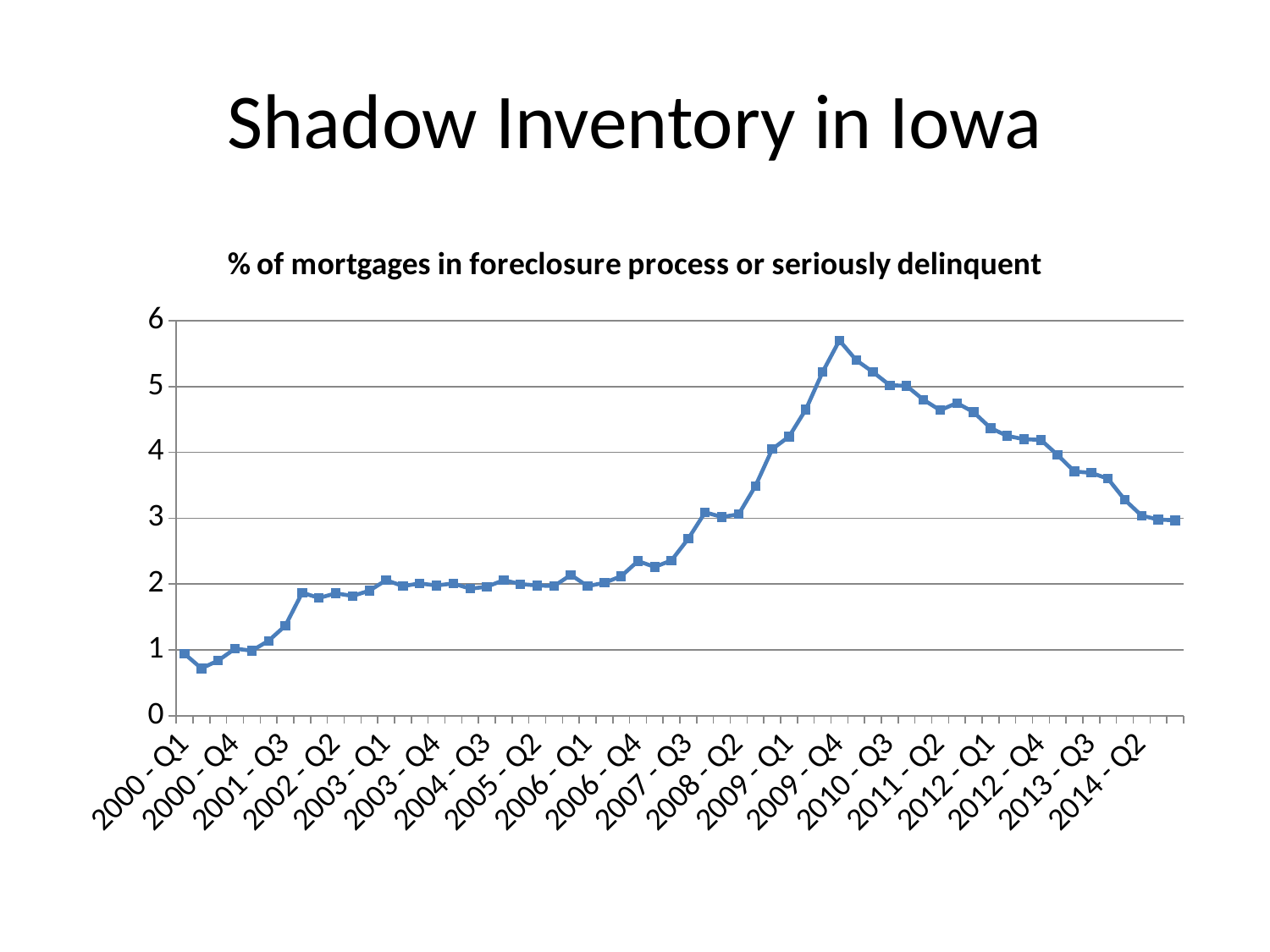
Which is larger, the value for 2009 - Q4 or the value for 2000 - Q1? 2009 - Q4 What is the title of the chart? % of mortgages in foreclosure process or seriously delinquent Do the values rise or fall between 2010 - Q3 and 2014 - Q2? fall Is the value for 2012 - Q1 greater or less than 4? greater What kind of chart is shown on the slide? line chart Is the value for 2011 - Q2 greater or less than 5? less Do the values rise or fall between 2006 - Q1 and 2009 - Q4? rise Is the value for 2002 - Q2 greater or less than 2? less